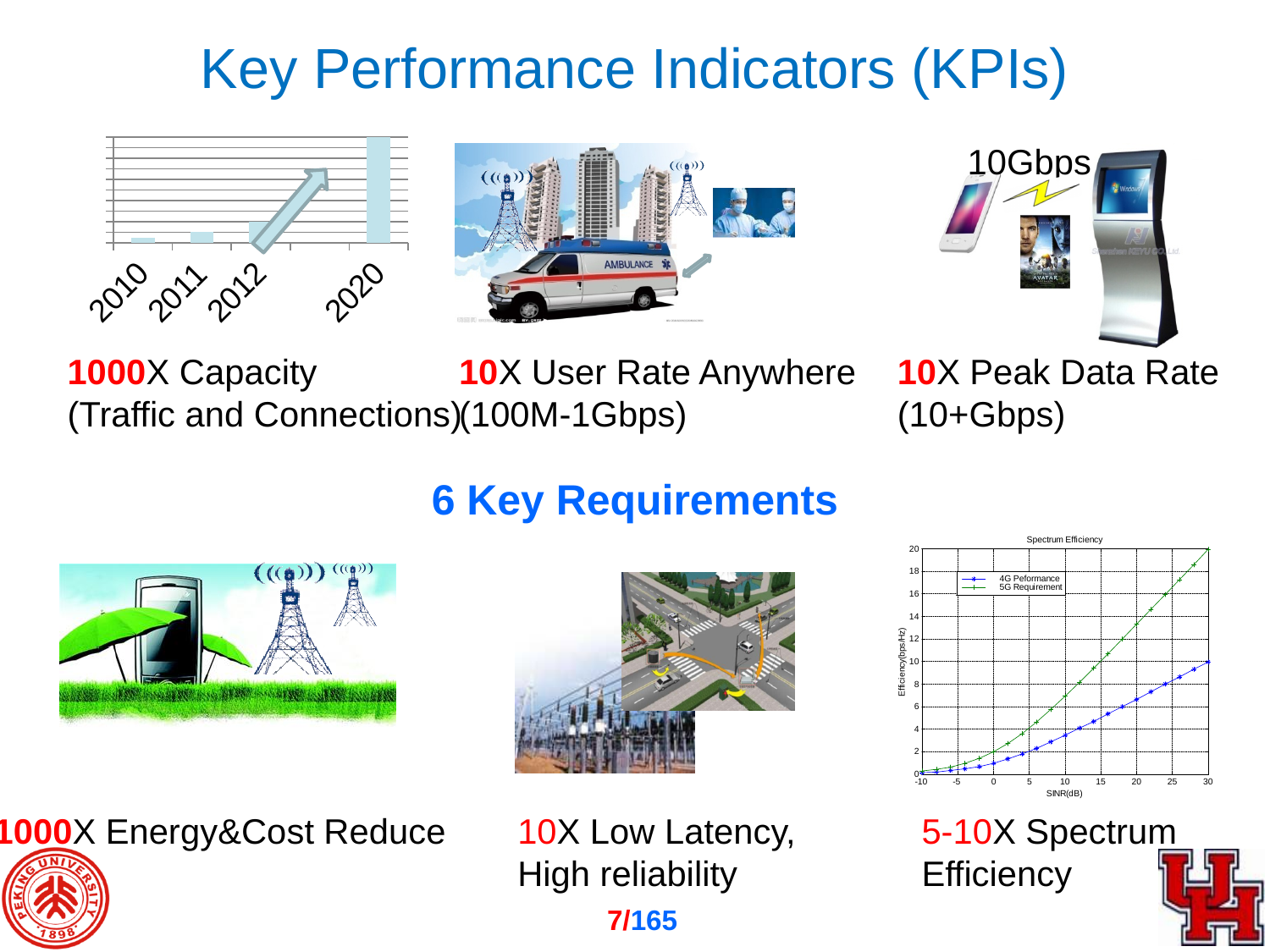
What is the title of the chart in the bottom-right of the slide? Spectrum Efficiency What kind of chart is the Spectrum Efficiency chart? line chart On the Spectrum Efficiency chart, which series is higher at SINR 30 dB: 4G Peformance or 5G Requirement? 5G Requirement How many year categories are shown on the top-left bar chart? 4 On the Spectrum Efficiency chart, do the values of both series rise or fall as SINR increases? rise What kind of chart is the top-left chart with the years 2010, 2011, 2012 and 2020? bar chart On the top-left bar chart, which year has the shortest bar? 2010 On the top-left bar chart, do the bars rise or fall from 2010 to 2020? rise On the top-left bar chart, which year has the tallest bar? 2020 What are the two series named in the legend of the Spectrum Efficiency chart? 4G Peformance and 5G Requirement How many series does the legend of the Spectrum Efficiency chart list? 2 On the Spectrum Efficiency chart, is the 4G Peformance value at SINR 30 dB greater or less than 15? less